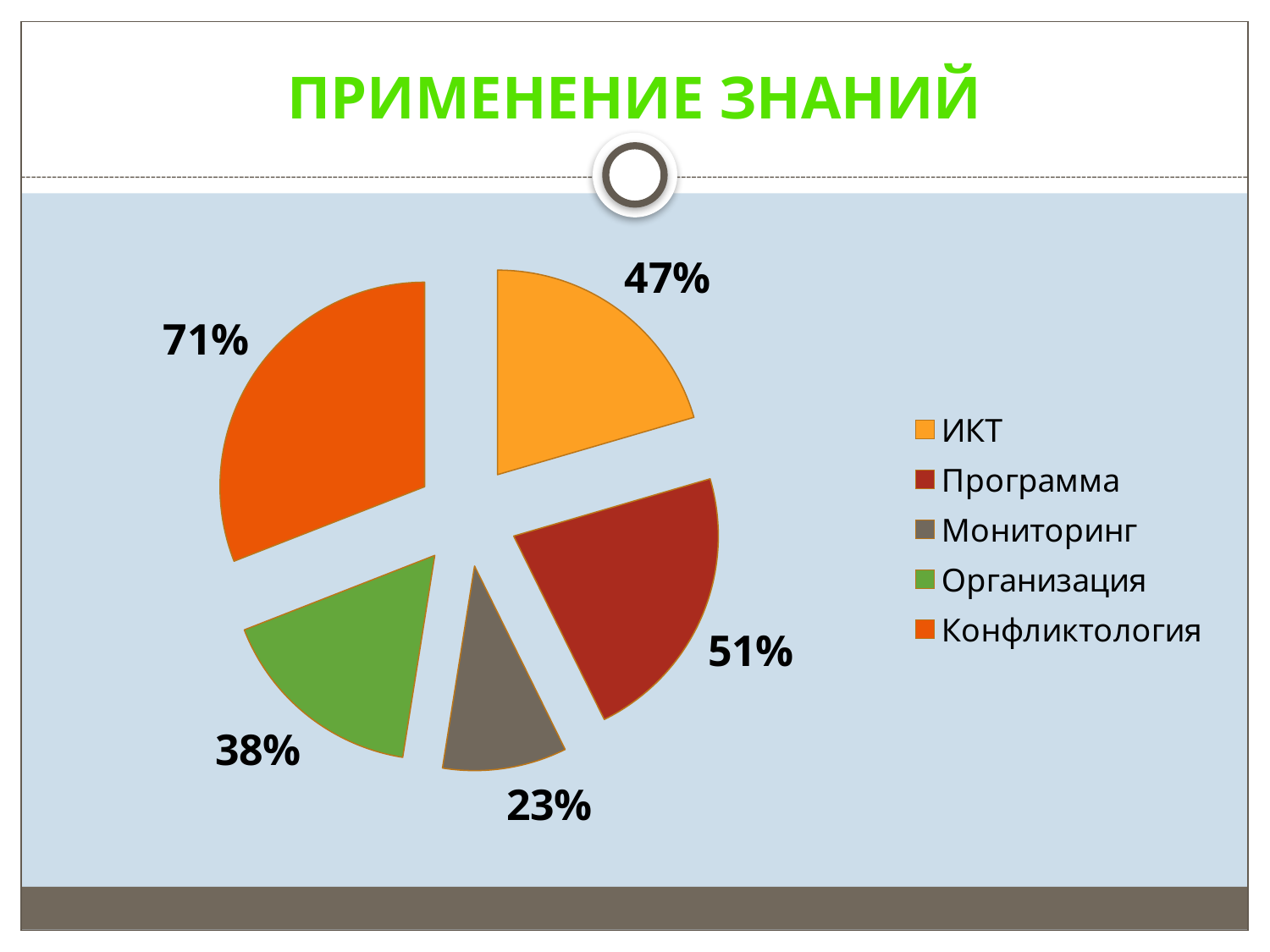
What type of chart is shown on the slide? pie chart What is the difference between the values for Конфликтология and Мониторинг? 48% Which category has the lowest value? Мониторинг What value is shown for Программа? 51% What value is shown for Конфликтология? 71% Which category has the highest value? Конфликтология What value is shown for Мониторинг? 23% Which is larger, the value for Программа or the value for Организация? Программа What value is shown for Организация? 38% How many slices does the pie chart have? 5 What value is shown for ИКТ? 47% What is the chart's title? ПРИМЕНЕНИЕ ЗНАНИЙ